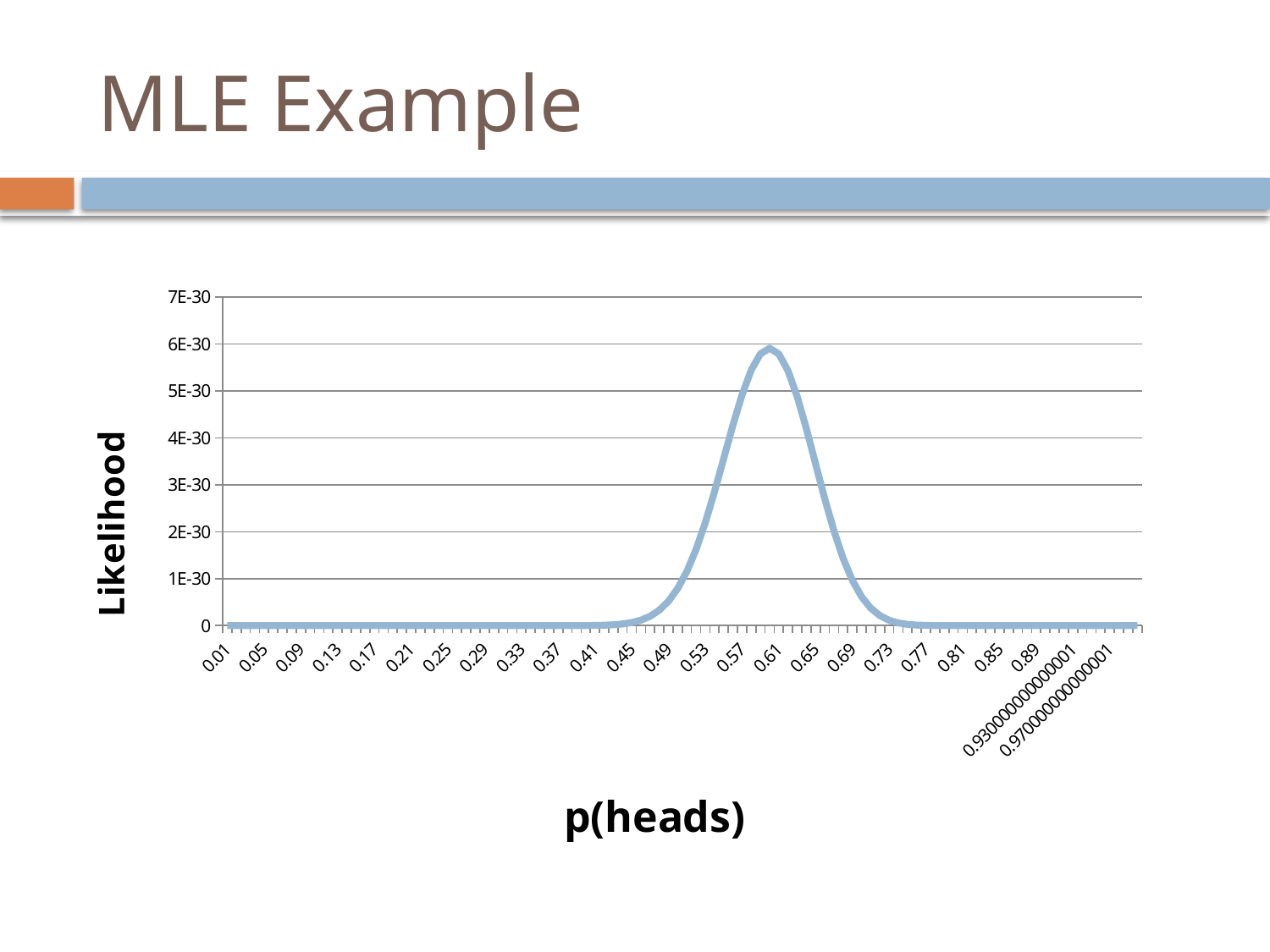
Which has the higher likelihood, p(heads) = 0.57 or p(heads) = 0.45? 0.57 Is the likelihood at p(heads) = 0.61 greater or less than 5E-30? greater What is the title of the x axis of the chart? p(heads) Is the likelihood at p(heads) = 0.57 greater or less than 3E-30? greater At which p(heads) value does the likelihood curve reach its peak? 0.61 Is the likelihood at p(heads) = 0.61 greater or less than 7E-30? less Which has the higher likelihood, p(heads) = 0.61 or p(heads) = 0.73? 0.61 Does the likelihood rise or fall as p(heads) increases from 0.61 to 0.77? fall What kind of chart is shown on the slide? line chart What is the title of the y axis of the chart? Likelihood